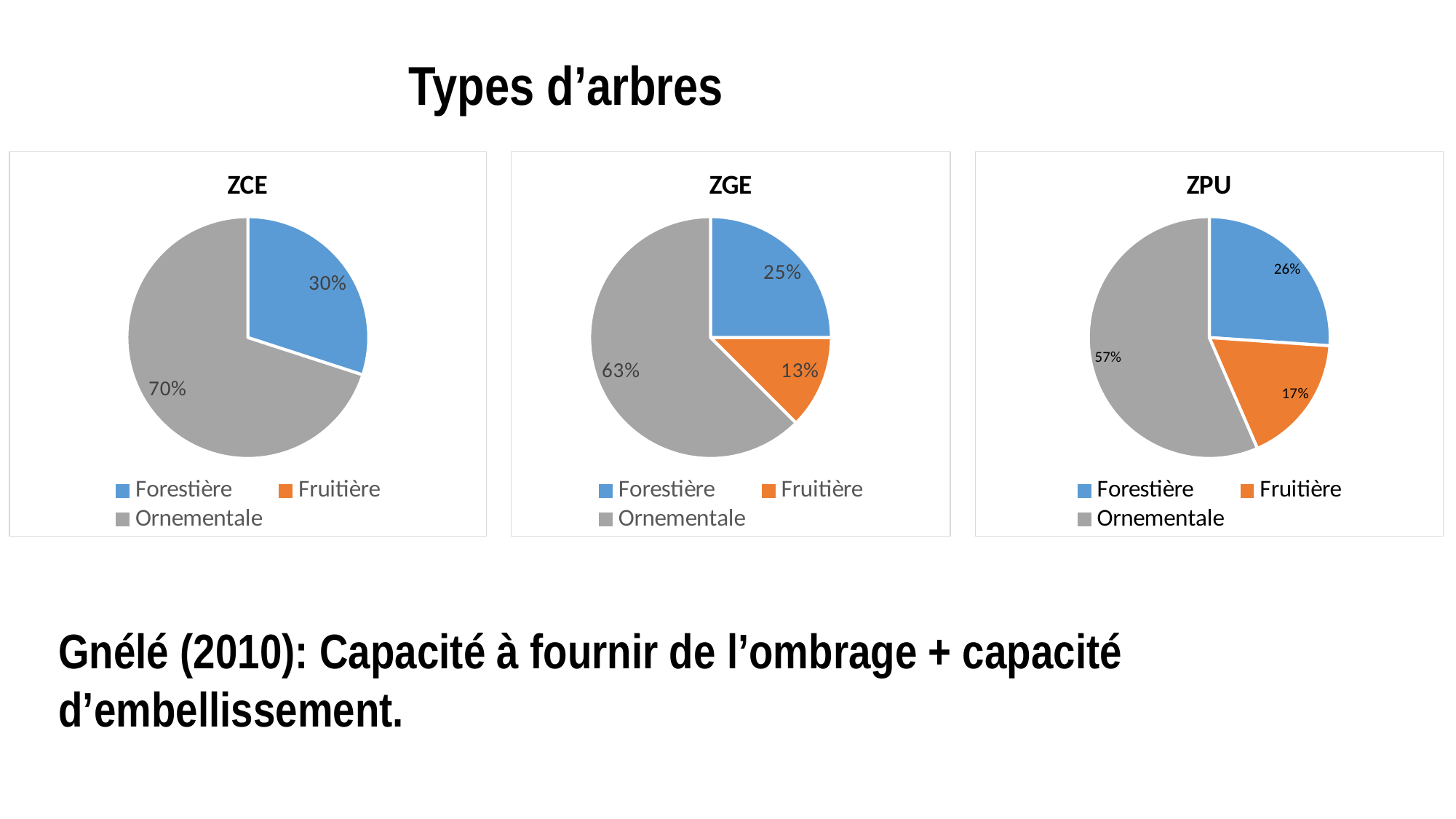
What kind of chart is the ZCE chart? Pie chart In the ZPU chart, which category has the largest slice? Ornementale In the ZGE chart, which category has the smallest slice? Fruitière How many entries does the legend of the ZPU chart list? 3 In the ZGE chart, what share of the pie is Fruitière? 13% In the ZCE chart, what share of the pie is Forestière? 30% In the ZGE chart, what share of the pie is Ornementale? 63% In the ZPU chart, what is the difference between the Forestière and Fruitière shares? 9% In the ZGE chart, which is larger, Forestière or Fruitière? Forestière